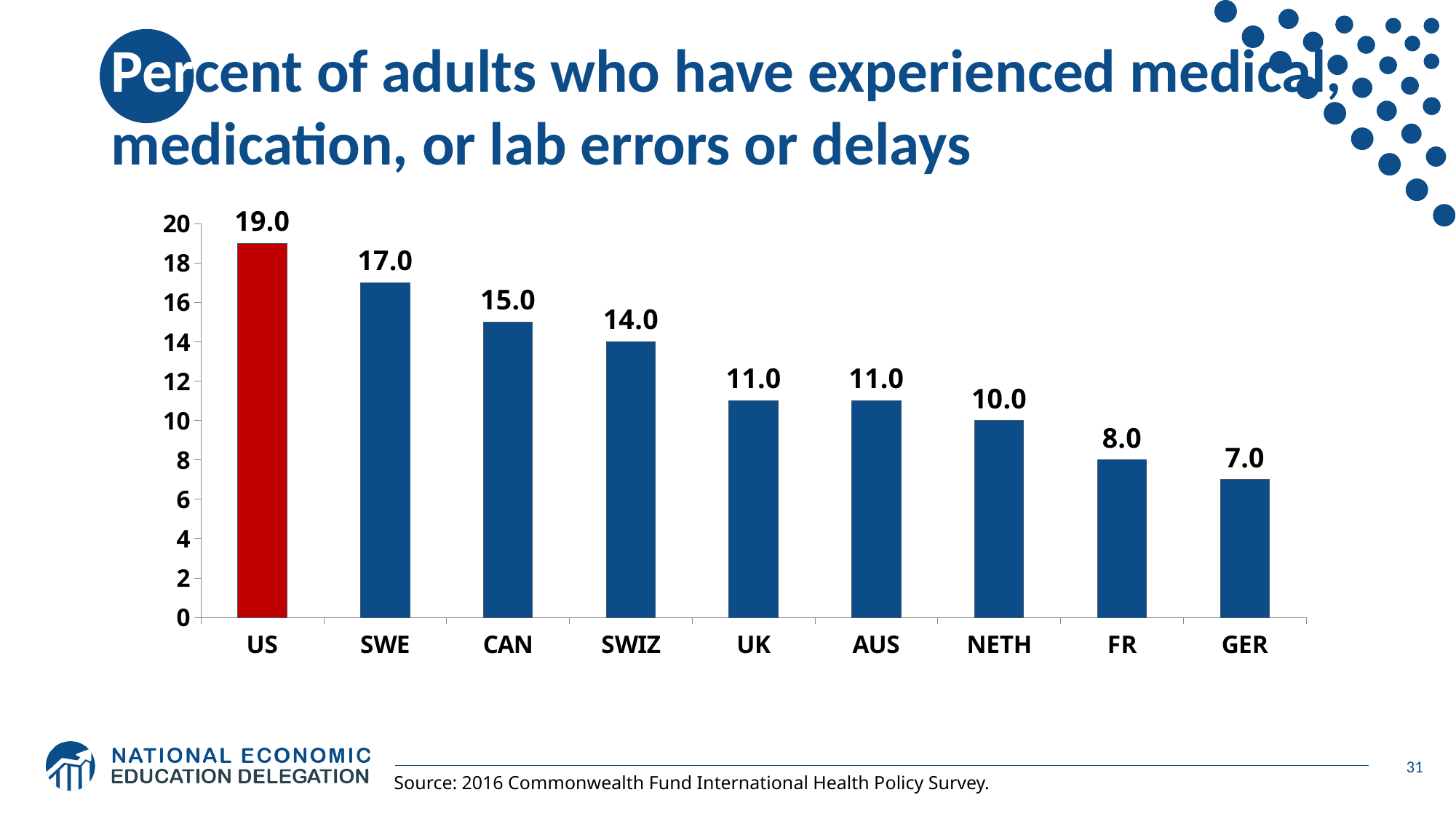
What is the value for SWE? 17.0 Which country has the lowest value? GER How many countries are shown on the chart? 9 Is the value for CAN greater or less than 10? greater Which bar is coloured red rather than blue? US What is the value for NETH? 10.0 Which is larger, the value for SWE or the value for FR? SWE What is the value for the US? 19.0 What is the difference between the values for the US and GER? 12.0 Which country has the highest value? US What kind of chart is shown on the slide? bar chart What is the difference between the values for CAN and SWIZ? 1.0